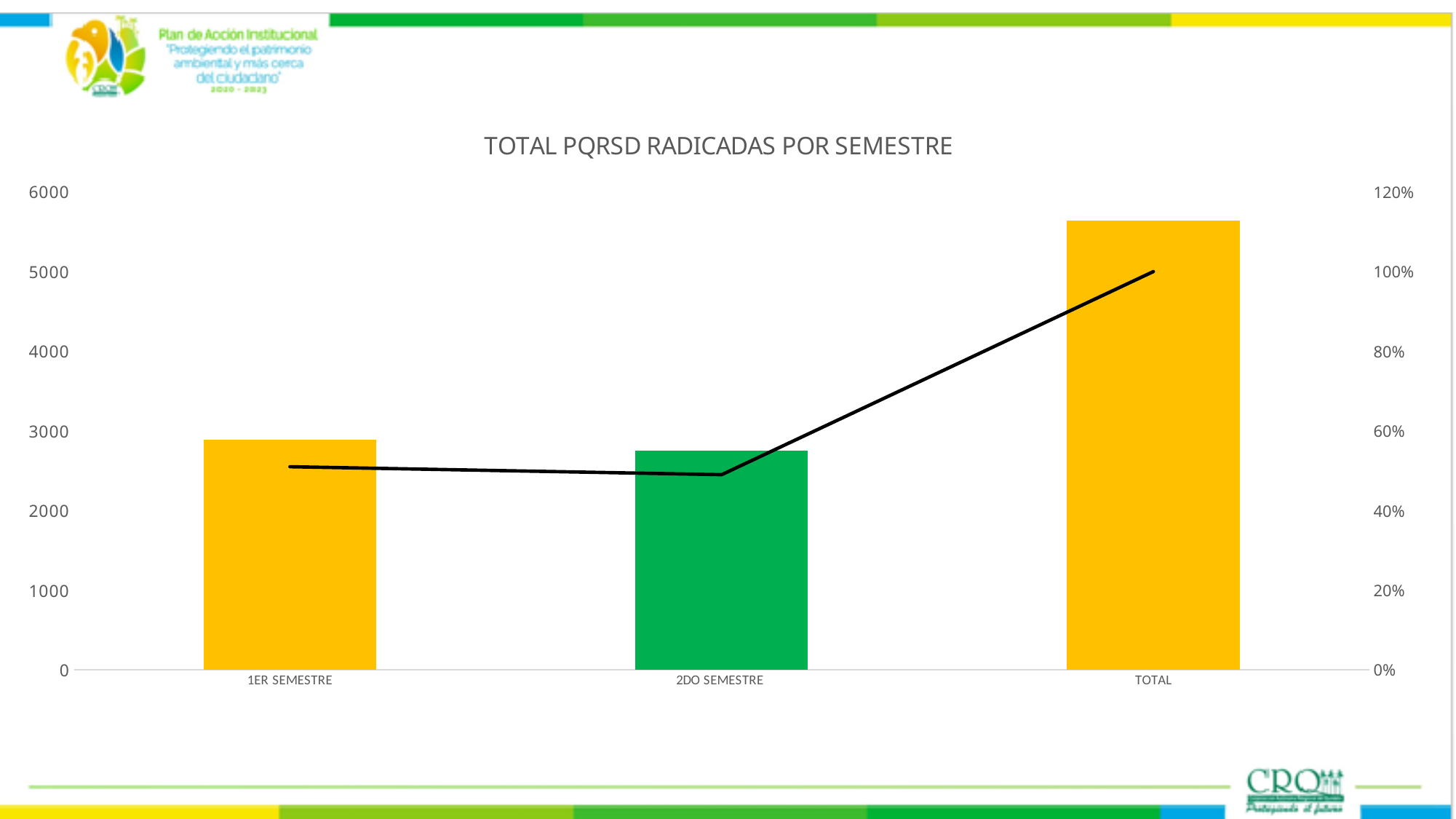
Which bar is taller, TOTAL or 2DO SEMESTRE? TOTAL Is the bar value for TOTAL greater or less than 5000? greater What colour is the bar for 2DO SEMESTRE? Green What type of chart is shown on the slide? Bar chart with a line Is the bar value for 2DO SEMESTRE greater or less than 2000? greater Is the bar value for 1ER SEMESTRE greater or less than 3000? less Which category has the shortest bar? 2DO SEMESTRE What is the title of the chart? TOTAL PQRSD RADICADAS POR SEMESTRE What percentage does the line reach at TOTAL on the right axis? 100% Which category has the tallest bar? TOTAL How many categories are shown on the x axis of the chart? 3